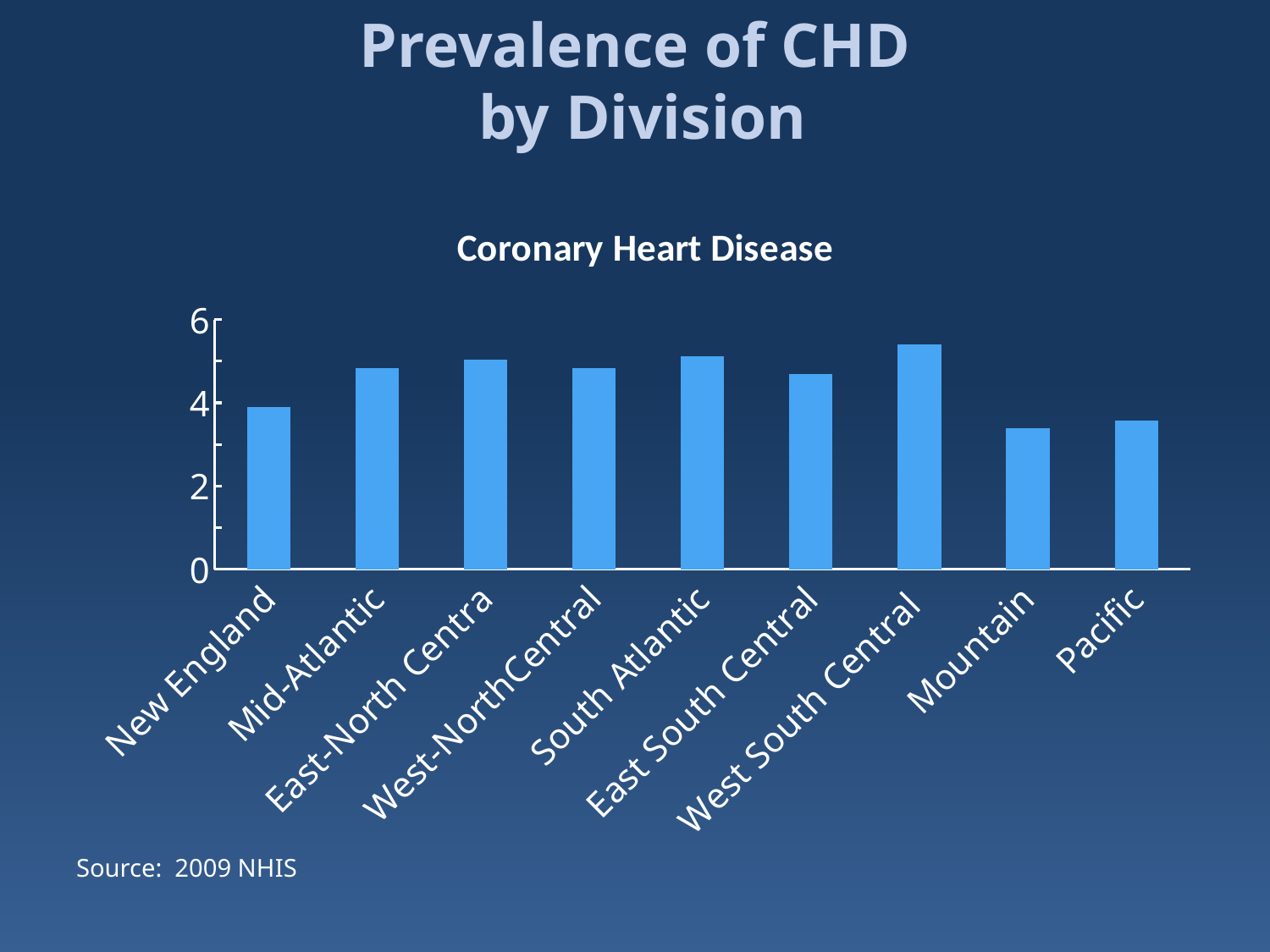
Is the value for South Atlantic greater or less than 6? less Which is larger, the value for West South Central or the value for Mountain? West South Central What source is cited for the chart data? 2009 NHIS Is the value for West South Central greater or less than 4? greater What kind of chart is shown on the slide? Bar chart What is the title shown directly above the chart? Coronary Heart Disease Is the value for Mid-Atlantic greater or less than 4? greater Which is larger, the value for New England or the value for Mid-Atlantic? Mid-Atlantic How many divisions are shown on the x axis of the chart? 9 Which division has the highest prevalence of coronary heart disease? West South Central